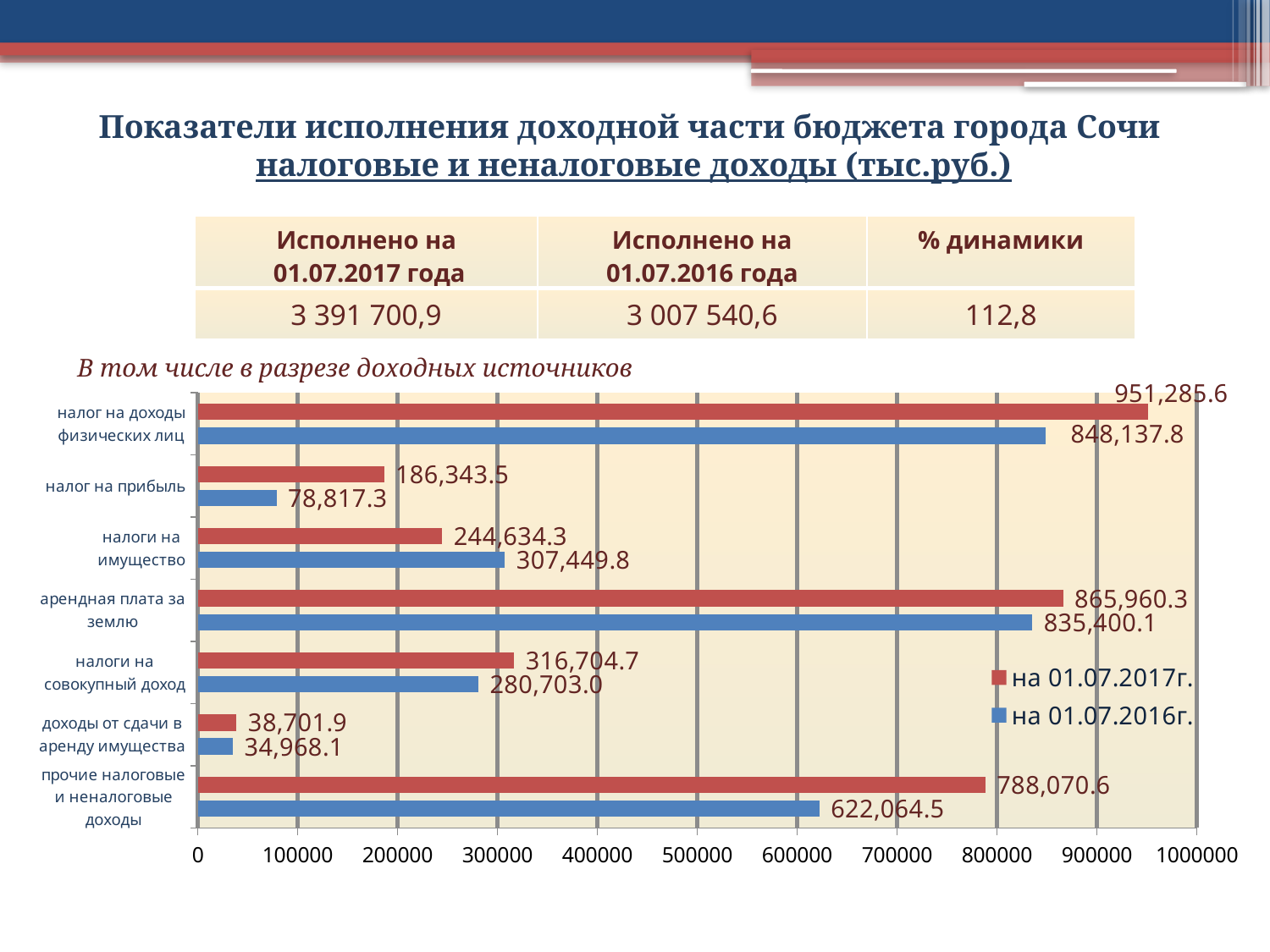
What kind of chart is shown on the slide? bar chart How many series does the chart legend list? 2 For 'налоги на имущество', which series has the larger value: 'на 01.07.2017г.' or 'на 01.07.2016г.'? на 01.07.2016г. How many income source categories are plotted on the chart? 7 What is the value for 'налог на доходы физических лиц' for the series 'на 01.07.2017г.'? 951,285.6 What is the difference between the 'на 01.07.2017г.' and 'на 01.07.2016г.' values for 'налог на прибыль'? 107,526.2 What is the value for 'доходы от сдачи в аренду имущества' for the series 'на 01.07.2017г.'? 38,701.9 Which category has the lowest value for the series 'на 01.07.2016г.'? доходы от сдачи в аренду имущества Which category has the highest value for the series 'на 01.07.2017г.'? налог на доходы физических лиц Which colour represents the series 'на 01.07.2016г.' in the chart? blue What is the value for 'налоги на имущество' for the series 'на 01.07.2016г.'? 307,449.8 What is the value for 'прочие налоговые и неналоговые доходы' for the series 'на 01.07.2016г.'? 622,064.5